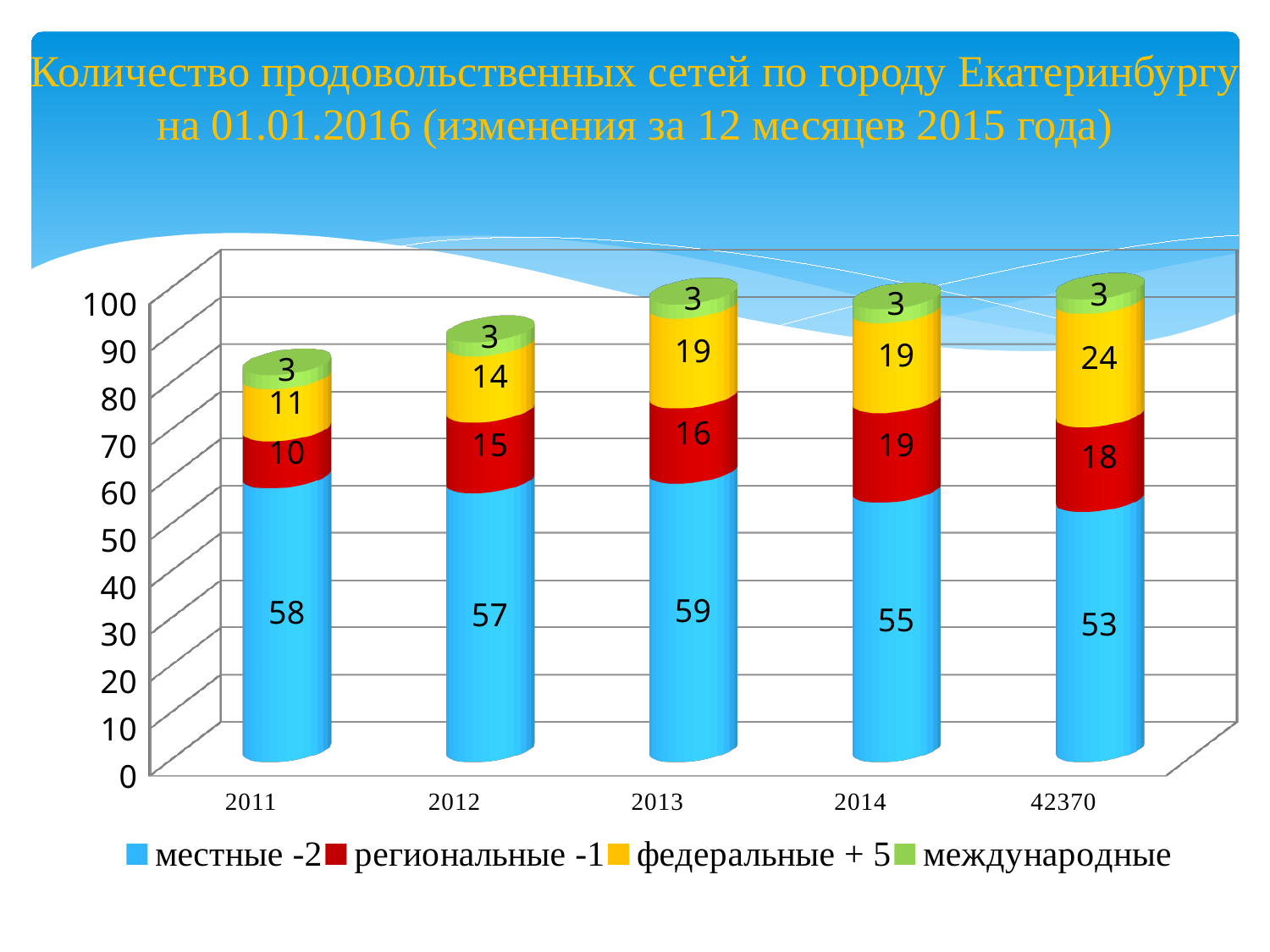
In which category is the местные -2 value the lowest? 42370 What is the value for местные -2 in 2013? 59 Which is larger, the региональные -1 value in 2012 or in 2013? 2013 What kind of chart is shown on the slide? Stacked bar chart What is the value for федеральные + 5 in the category labelled 42370? 24 What is the total of the stacked bar for 2013? 97 How many categories are shown on the x axis? 5 How many series does the legend list? 4 What is the value for региональные -1 in 2014? 19 What is the difference between the федеральные + 5 values for 2011 and 2012? 3 What is the total of the stacked bar for 2011? 82 In which year is the местные -2 value the highest? 2013